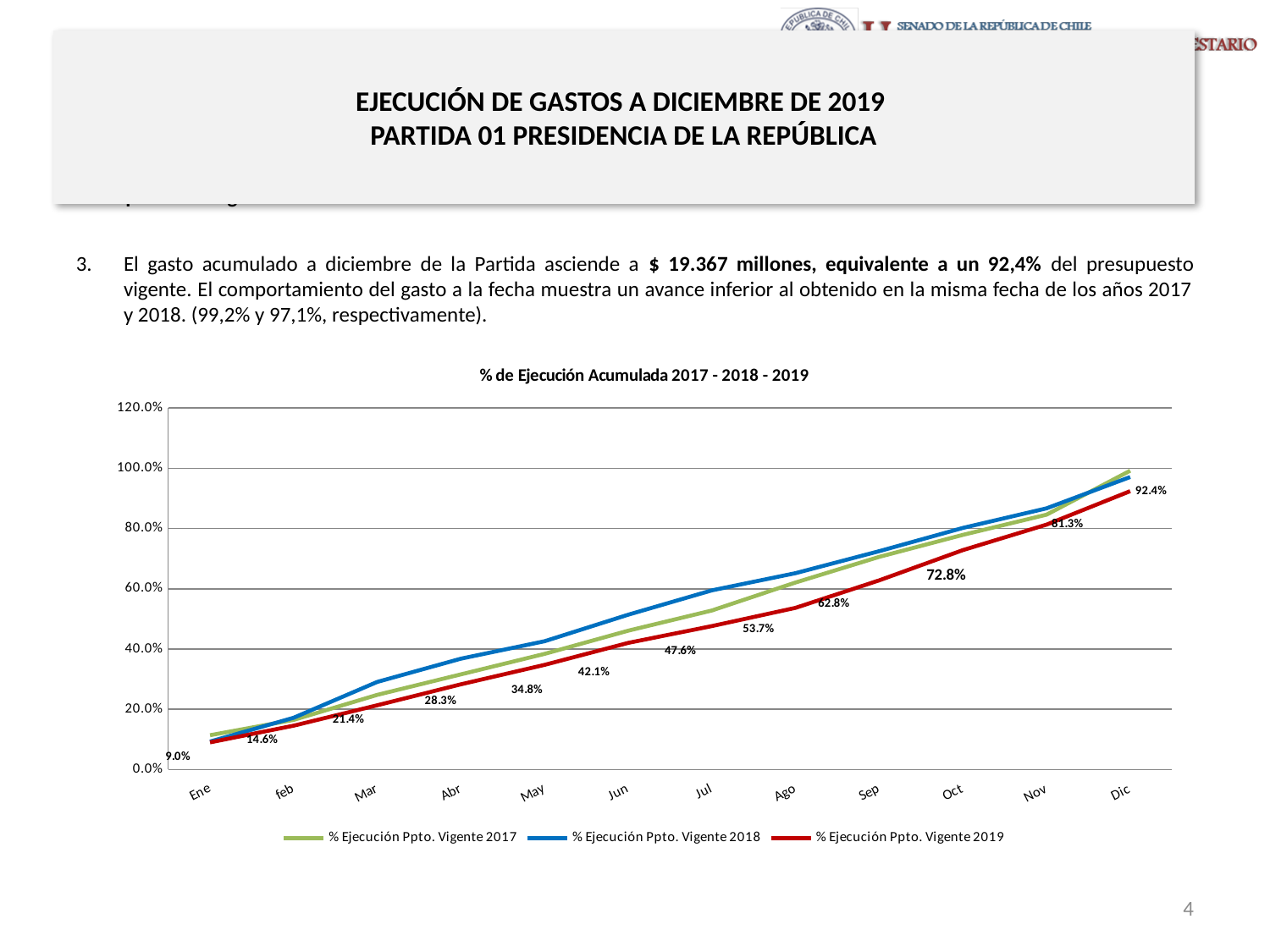
What is the value of % Ejecución Ppto. Vigente 2019 for Dic? 92.4% What type of chart is shown on the slide? line chart Does the % Ejecución Ppto. Vigente 2019 series rise or fall from Ene to Dic? rise What is the value of % Ejecución Ppto. Vigente 2019 for Jun? 42.1% How many months are plotted along the x axis of the chart? 12 What is the difference between the % Ejecución Ppto. Vigente 2019 values for Oct and Sep? 10.0% In Jul, which series is higher: % Ejecución Ppto. Vigente 2018 or % Ejecución Ppto. Vigente 2019? % Ejecución Ppto. Vigente 2018 How many series does the chart legend list? 3 In which month is the % Ejecución Ppto. Vigente 2019 series lowest? Ene Is the value for % Ejecución Ppto. Vigente 2017 in Jun greater or less than 60.0%? less What is the title of the chart? % de Ejecución Acumulada 2017 - 2018 - 2019 What is the value of % Ejecución Ppto. Vigente 2019 for Ene? 9.0%